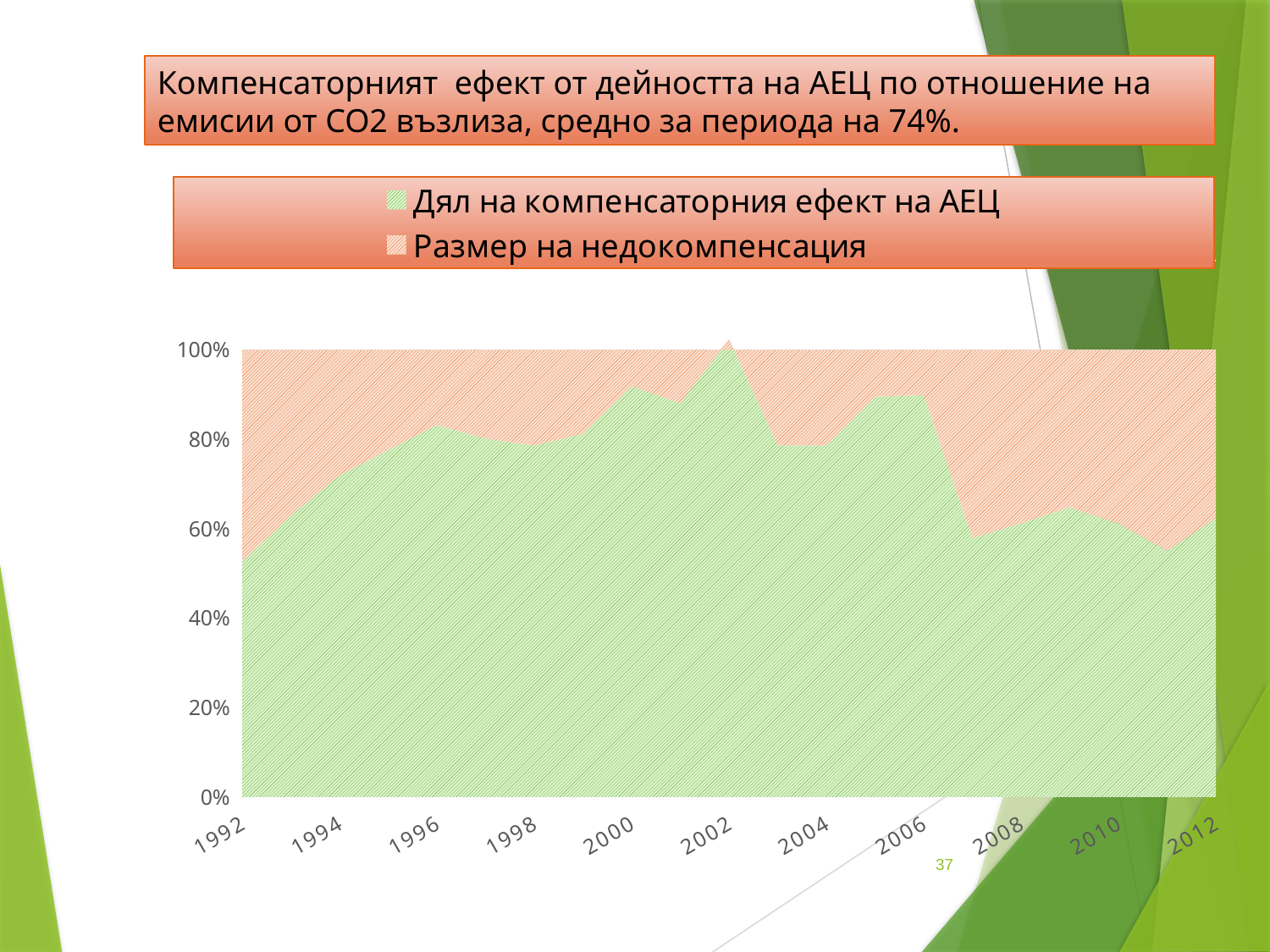
Is the value of 'Дял на компенсаторния ефект на АЕЦ' in 2008 greater or less than 80%? less What kind of chart is shown on the slide? area chart Which colour represents the series 'Дял на компенсаторния ефект на АЕЦ'? green Is the value of 'Дял на компенсаторния ефект на АЕЦ' in 2002 greater or less than 80%? greater Which year has the larger value for 'Дял на компенсаторния ефект на АЕЦ', 1992 or 2002? 2002 Is the value of 'Дял на компенсаторния ефект на АЕЦ' in 2006 greater or less than 80%? greater In which year does 'Дял на компенсаторния ефект на АЕЦ' reach its highest value? 2002 Does the value of 'Дял на компенсаторния ефект на АЕЦ' rise or fall from 1992 to 1996? rise What are the two series named in the chart legend? Дял на компенсаторния ефект на АЕЦ; Размер на недокомпенсация How many year labels are shown on the x axis? 11 How many series does the chart legend list? 2